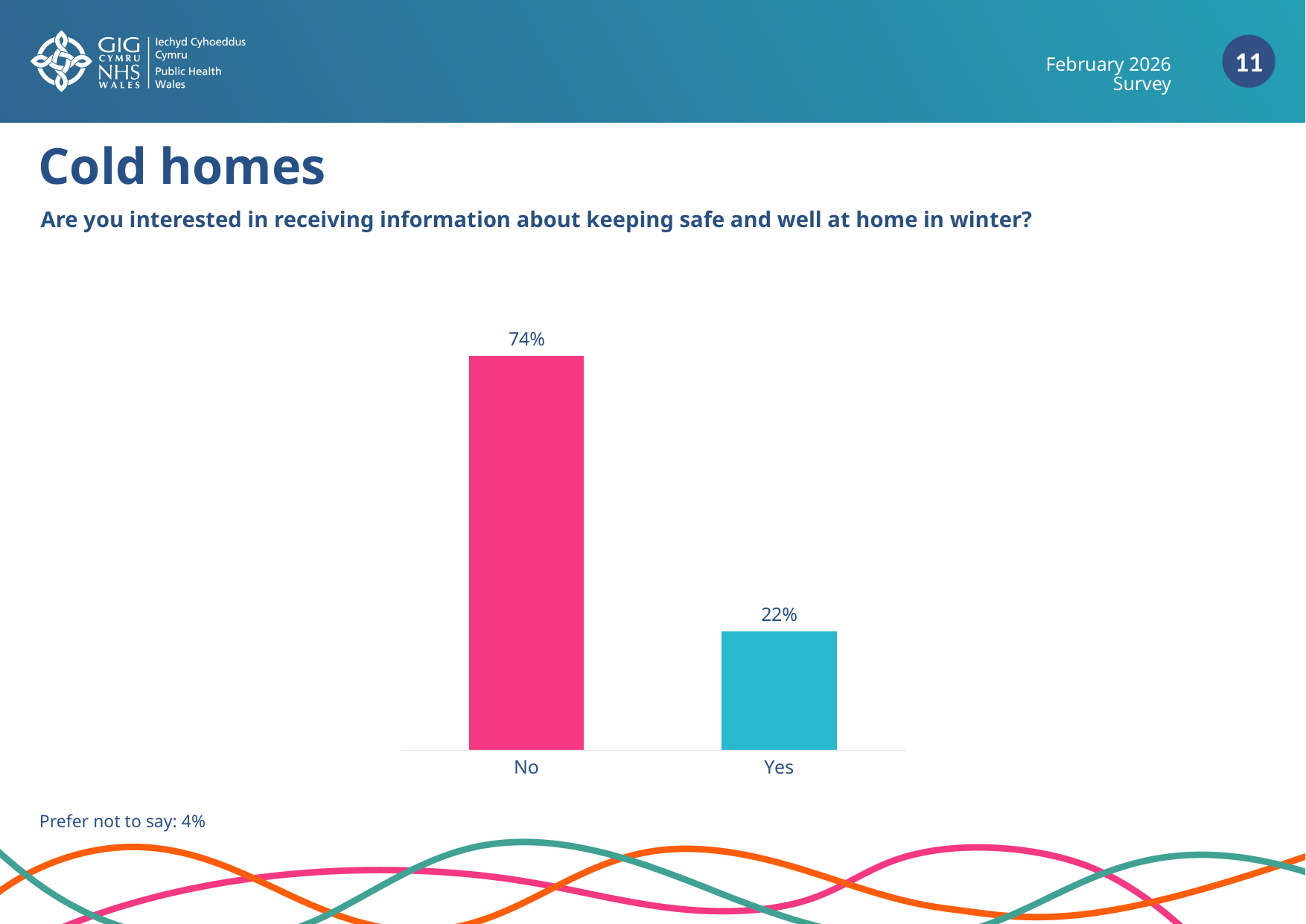
What colour is the bar for the "Yes" response? Teal How many response categories are plotted in the chart? 2 What kind of chart is shown on the slide? Bar chart Which response has the highest percentage in the chart? No What percentage of respondents answered "Yes" to being interested in receiving information about keeping safe and well at home in winter? 22% What percentage of respondents preferred not to say, according to the note below the chart? 4% Which response is larger, "No" or "Yes"? No What percentage of respondents answered "No" to being interested in receiving information about keeping safe and well at home in winter? 74% What colour is the bar for the "No" response? Pink Which response has the lowest percentage in the chart? Yes What is the difference in percentage points between the "No" and "Yes" responses? 52 percentage points